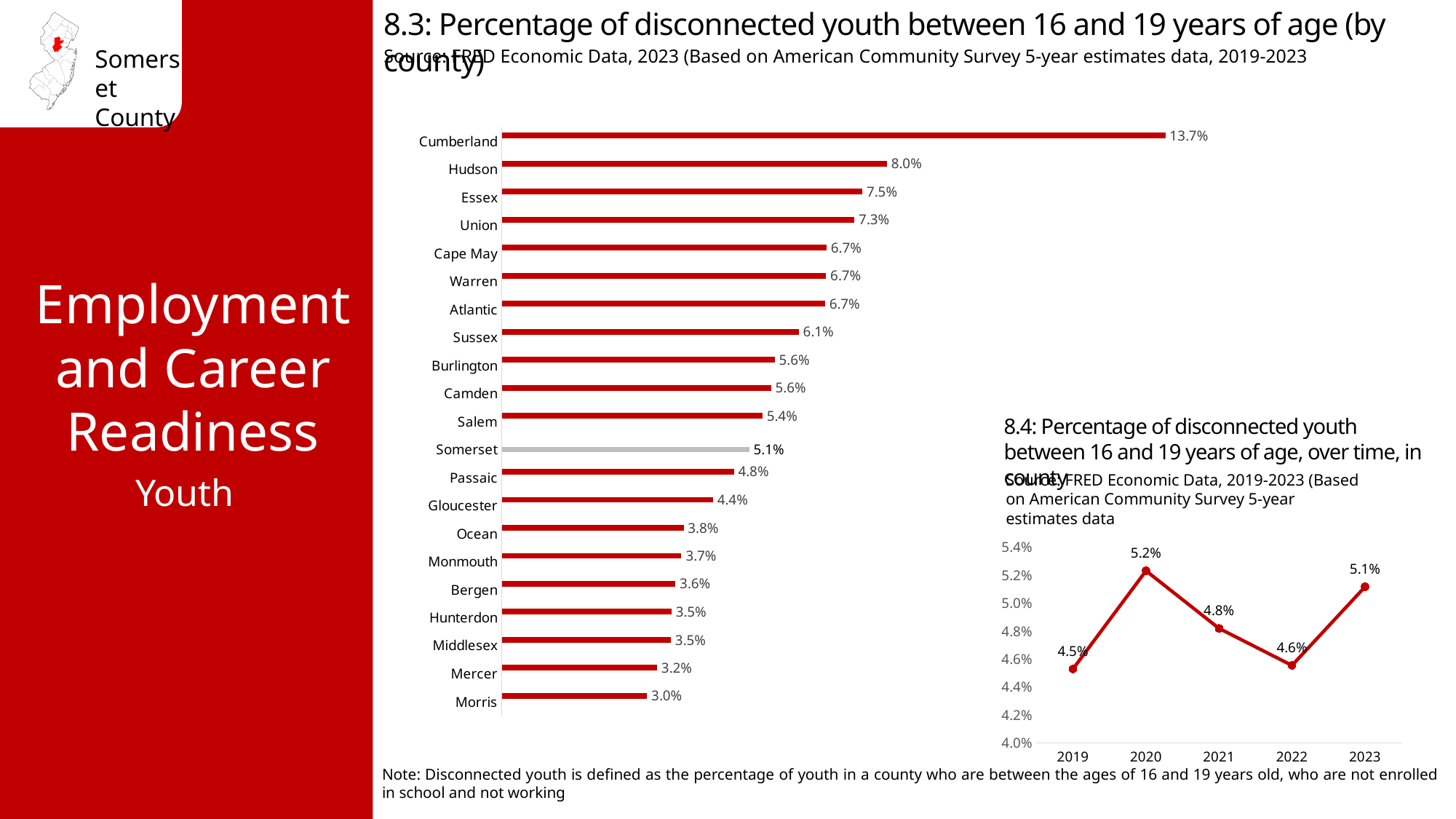
In chart 8.4, what was the percentage of disconnected youth in 2020? 5.2% In chart 8.4, how many years are plotted? 5 In chart 8.3, which county has the lowest percentage of disconnected youth? Morris In chart 8.3, which county has a larger value, Passaic or Gloucester? Passaic In chart 8.3, which county has the highest percentage of disconnected youth? Cumberland What type of chart is chart 8.3? Bar chart In chart 8.3, what is the difference between Cumberland's value and Hudson's value? 5.7% In chart 8.3, what is the percentage of disconnected youth for Somerset? 5.1% In chart 8.3, how many counties are shown? 21 In chart 8.3, what is the value for Mercer? 3.2% In chart 8.4, which year had the lowest percentage of disconnected youth? 2019 In chart 8.4, what is the difference between the 2023 value and the 2022 value? 0.5%